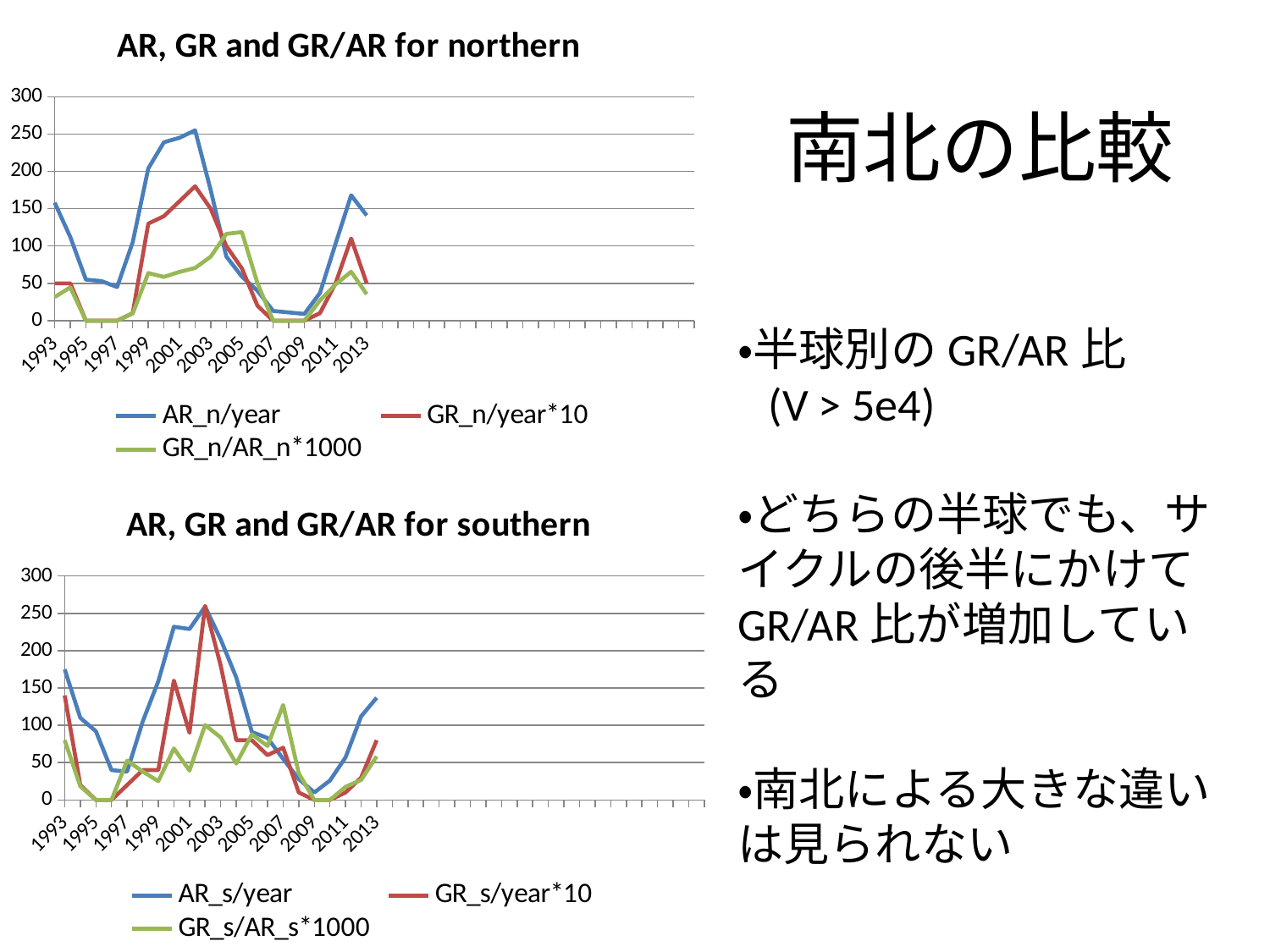
In the 'AR, GR and GR/AR for southern' chart, is the value of AR_s/year in 1993 greater or less than 150? greater What kind of chart is the 'AR, GR and GR/AR for northern' chart? line chart In the 'AR, GR and GR/AR for northern' chart, is the value of AR_n/year in 2001 greater or less than 200? greater In the 'AR, GR and GR/AR for northern' chart, which series is drawn in green? GR_n/AR_n*1000 In the 'AR, GR and GR/AR for northern' chart, in which year does AR_n/year reach its highest value? 2002 How many year labels are shown on the x axis of the 'AR, GR and GR/AR for southern' chart? 11 In the 'AR, GR and GR/AR for southern' chart, does AR_s/year rise or fall from 2002 to 2009? fall In the 'AR, GR and GR/AR for southern' chart, is the value of GR_s/year*10 in 2009 greater or less than 50? less In the 'AR, GR and GR/AR for northern' chart, does AR_n/year rise or fall from 1997 to 2002? rise In the 'AR, GR and GR/AR for southern' chart, which is larger in 2001: AR_s/year or GR_s/year*10? AR_s/year How many series does the legend of the 'AR, GR and GR/AR for southern' chart list? 3